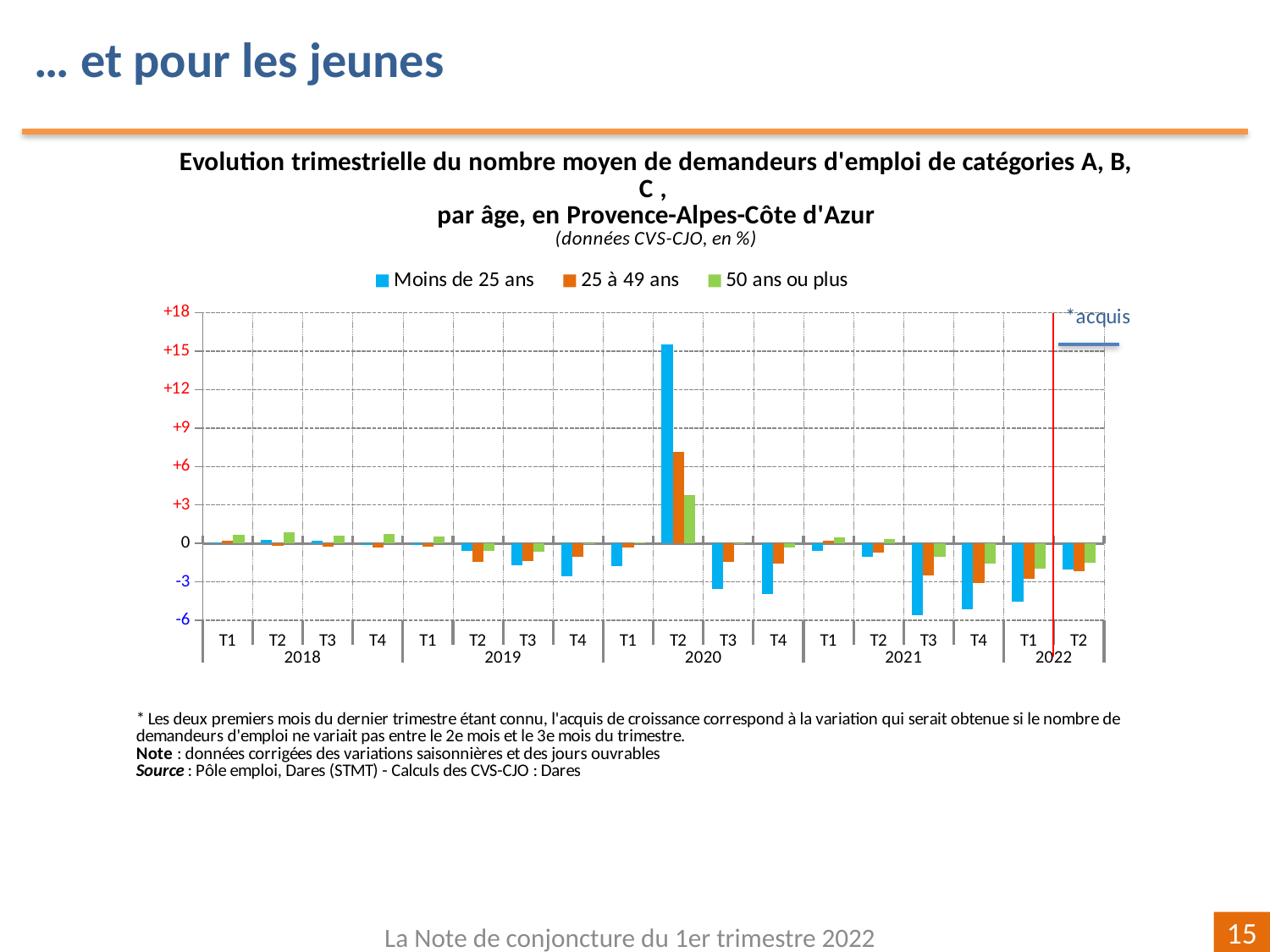
Is the value for 25 à 49 ans in T2 2020 greater or less than +6? greater Is the value for Moins de 25 ans in T4 2020 greater or less than -3? less Is the value for Moins de 25 ans in T3 2021 greater or less than -3? less Which colour represents the series Moins de 25 ans in the legend? blue In T2 2020, which series has the larger value: Moins de 25 ans or 25 à 49 ans? Moins de 25 ans Which quarter is marked by the red vertical line labelled *acquis? T2 2022 What kind of chart is shown on the slide? bar chart How many quarters are plotted along the x axis? 18 In which quarter is the value for Moins de 25 ans the highest? T2 2020 How many series does the legend list? 3